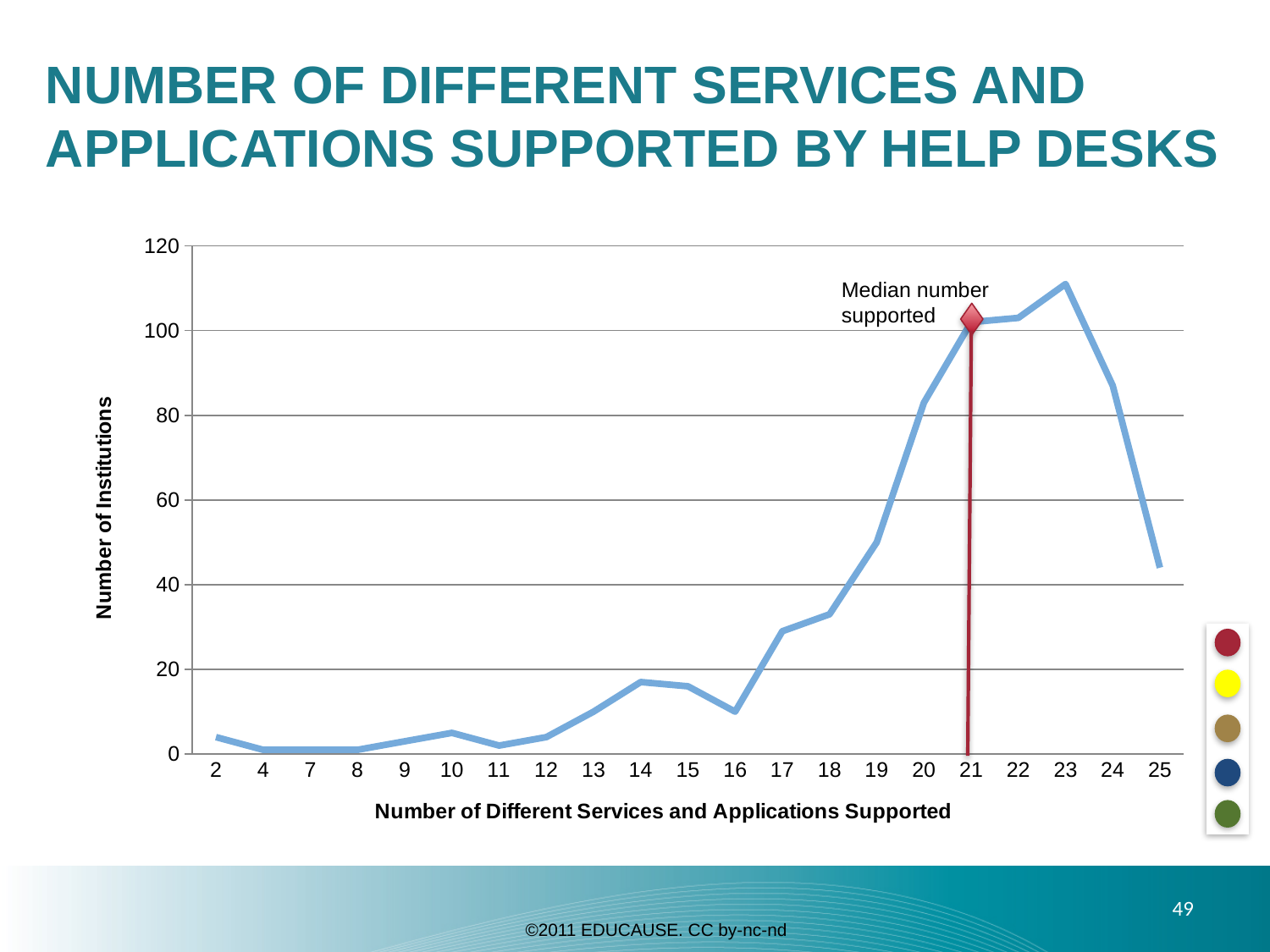
Is the number of institutions for 17 services and applications supported greater or less than 20? greater Which has more institutions: 23 or 25 services and applications supported? 23 How many points are plotted along the x axis of the chart? 21 Is the number of institutions for 25 services and applications supported greater or less than 60? less What kind of chart is shown on the slide? line chart At which number of services and applications supported is the median marked on the chart? 21 Is the number of institutions for 19 services and applications supported greater or less than 60? less Which has more institutions: 20 or 19 services and applications supported? 20 Does the number of institutions rise or fall from 23 to 25 services and applications supported? fall At which number of different services and applications supported is the number of institutions highest? 23